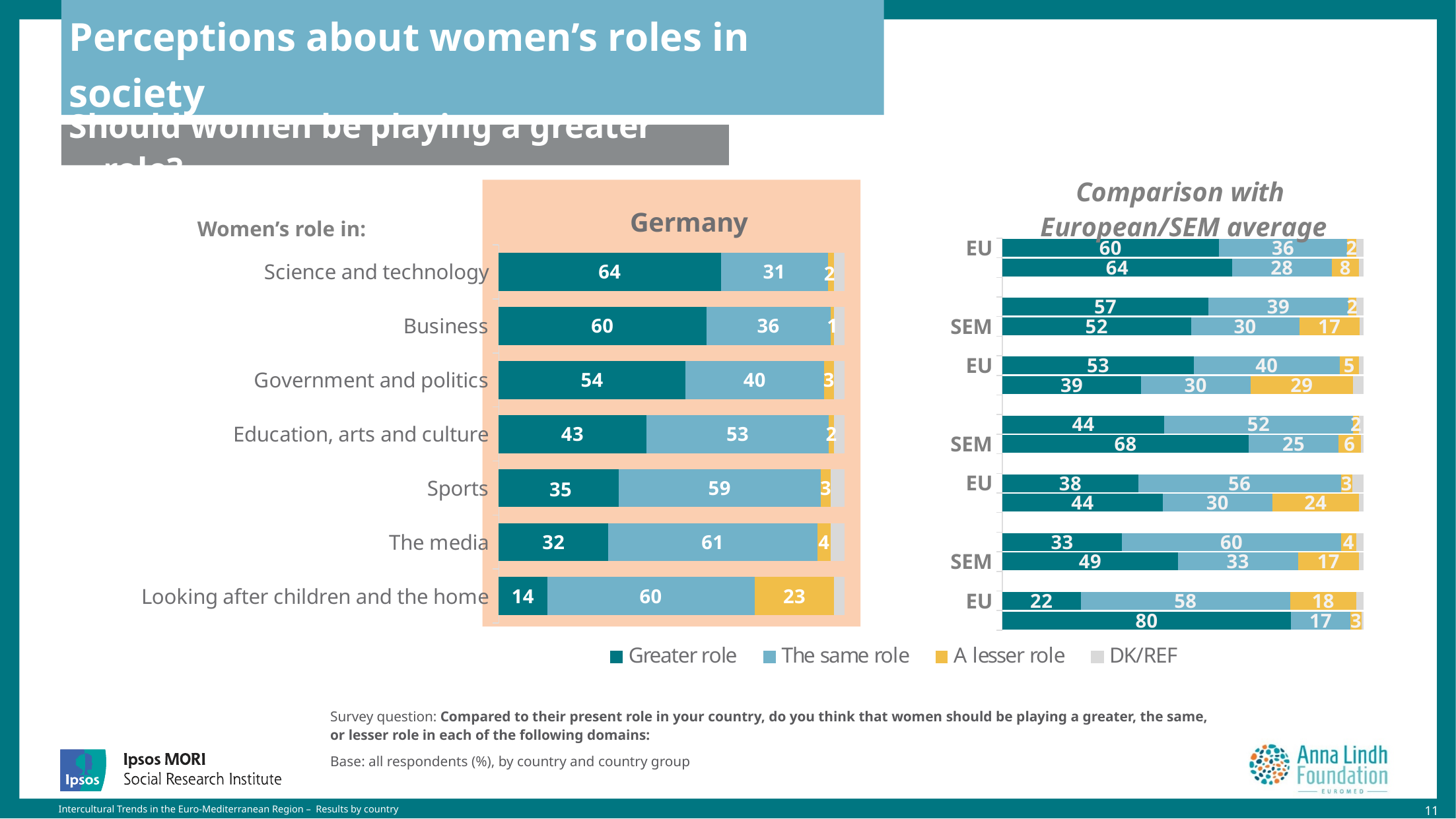
In the Germany chart, which domain has the highest 'Greater role' value? Science and technology How many domains are listed in the Germany chart? 7 What kind of chart is the Germany chart? Stacked bar chart In the Comparison with European/SEM average chart, what is the 'Greater role' value in the bottommost bar? 80 In the Germany chart, what percentage say women should play a greater role in Science and technology? 64 In the Germany chart, what is the 'The same role' value for The media? 61 In the Germany chart, is the 'The same role' value larger for Sports or for Government and politics? Sports In the Germany chart, which domain has the lowest 'Greater role' value? Looking after children and the home In the Germany chart, what is the difference between the 'Greater role' values for Business and Sports? 25 In the Germany chart, what is the 'A lesser role' value for Looking after children and the home? 23 In the Comparison with European/SEM average chart, what is the 'Greater role' value in the topmost EU bar? 60 How many series does the legend list? 4